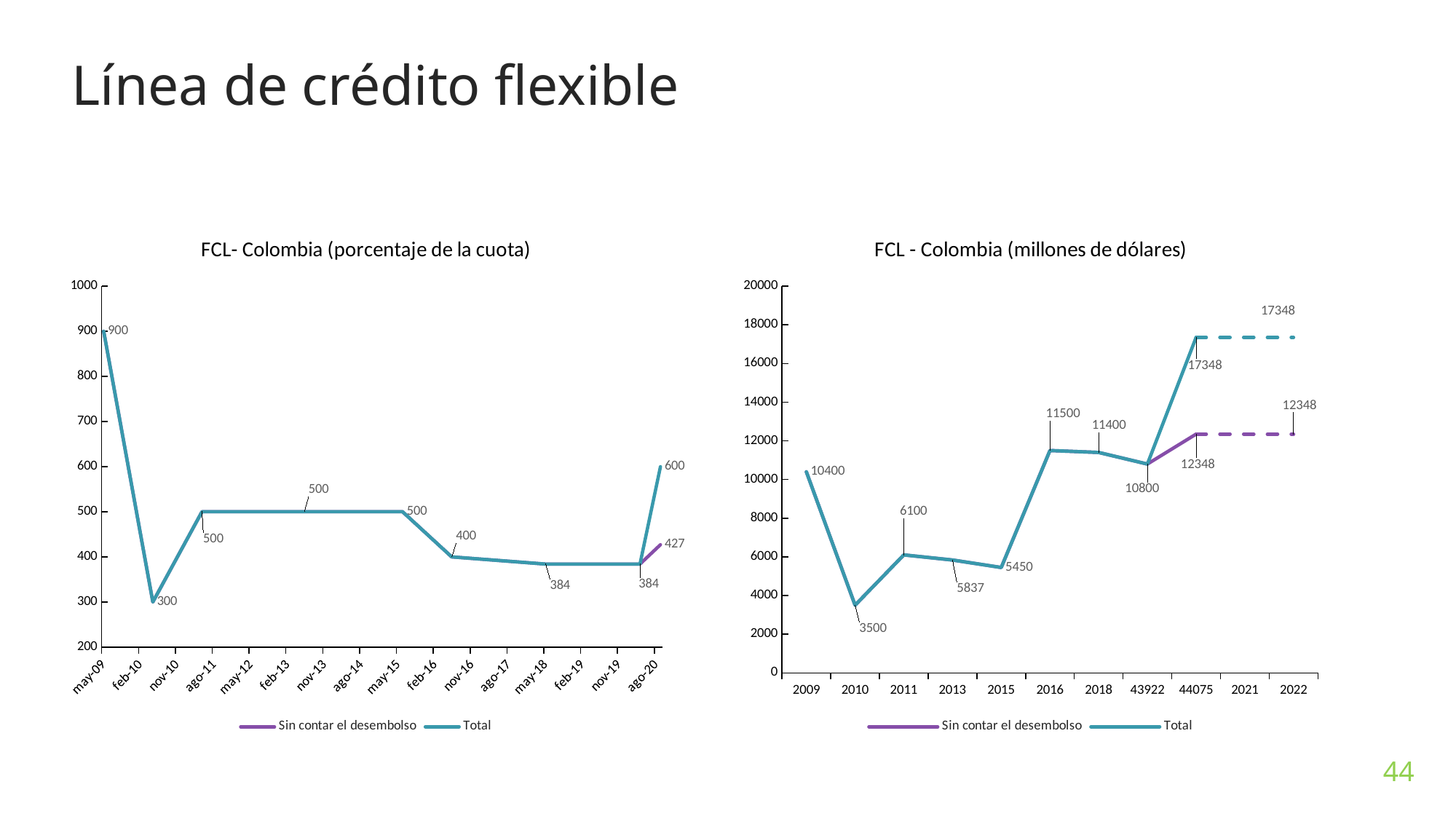
In the chart titled "FCL - Colombia (millones de dólares)", what is the value for 2009? 10400 In the chart titled "FCL- Colombia (porcentaje de la cuota)", what is the Sin contar el desembolso value at ago-20? 427 What kind of chart is the chart titled "FCL- Colombia (porcentaje de la cuota)"? Line chart In the chart titled "FCL - Colombia (millones de dólares)", what is the value for 2010? 3500 In the chart titled "FCL- Colombia (porcentaje de la cuota)", what is the Total value at ago-20? 600 In the chart titled "FCL- Colombia (porcentaje de la cuota)", what is the value at may-09? 900 In the chart titled "FCL - Colombia (millones de dólares)", which is larger, the value for 2011 or the value for 2015? 2011 In the chart titled "FCL - Colombia (millones de dólares)", which year has the lowest value? 2010 In the chart titled "FCL - Colombia (millones de dólares)", what is the difference between the values for 2016 and 2018? 100 In the chart titled "FCL - Colombia (millones de dólares)", what is the highest value of the Total series? 17348 In the chart titled "FCL - Colombia (millones de dólares)", what is the difference between the Total and the Sin contar el desembolso values at 2022? 5000 In the chart titled "FCL- Colombia (porcentaje de la cuota)", what is the lowest value plotted? 300